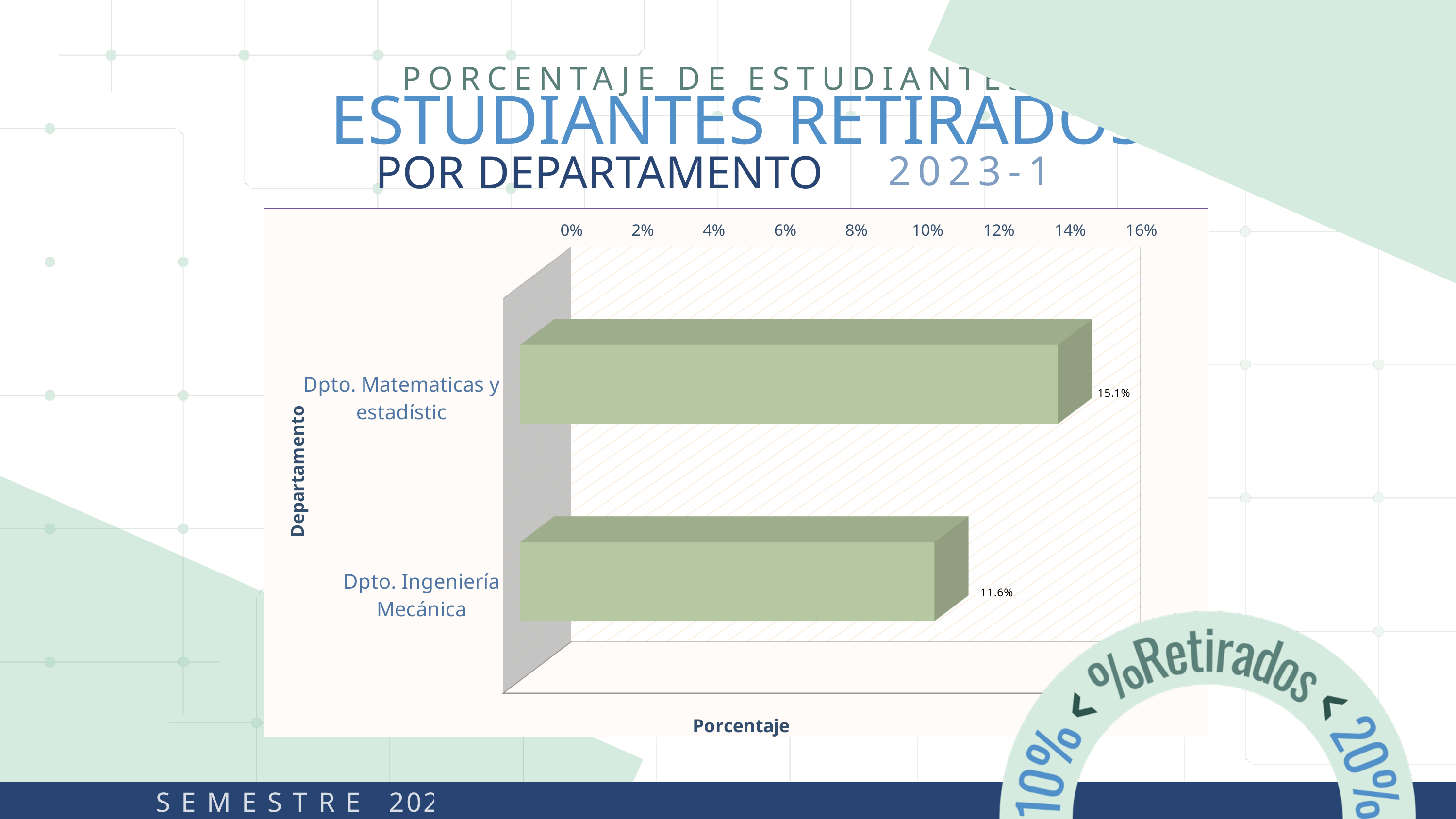
Which department has the lowest percentage? Dpto. Ingeniería Mecánica How many departments are shown in the chart? 2 What is the difference between the values for Dpto. Matematicas y estadístic and Dpto. Ingeniería Mecánica? 3.5% Which is larger, the value for Dpto. Ingeniería Mecánica or the value for Dpto. Matematicas y estadístic? Dpto. Matematicas y estadístic What is the label of the vertical axis? Departamento What is the value for Dpto. Ingeniería Mecánica? 11.6% Is the value for Dpto. Matematicas y estadístic greater or less than 16%? less What is the value for Dpto. Matematicas y estadístic? 15.1% What kind of chart is shown on the slide? bar chart What is the label of the horizontal axis? Porcentaje Is the value for Dpto. Ingeniería Mecánica greater or less than 10%? greater Which department has the highest percentage? Dpto. Matematicas y estadístic